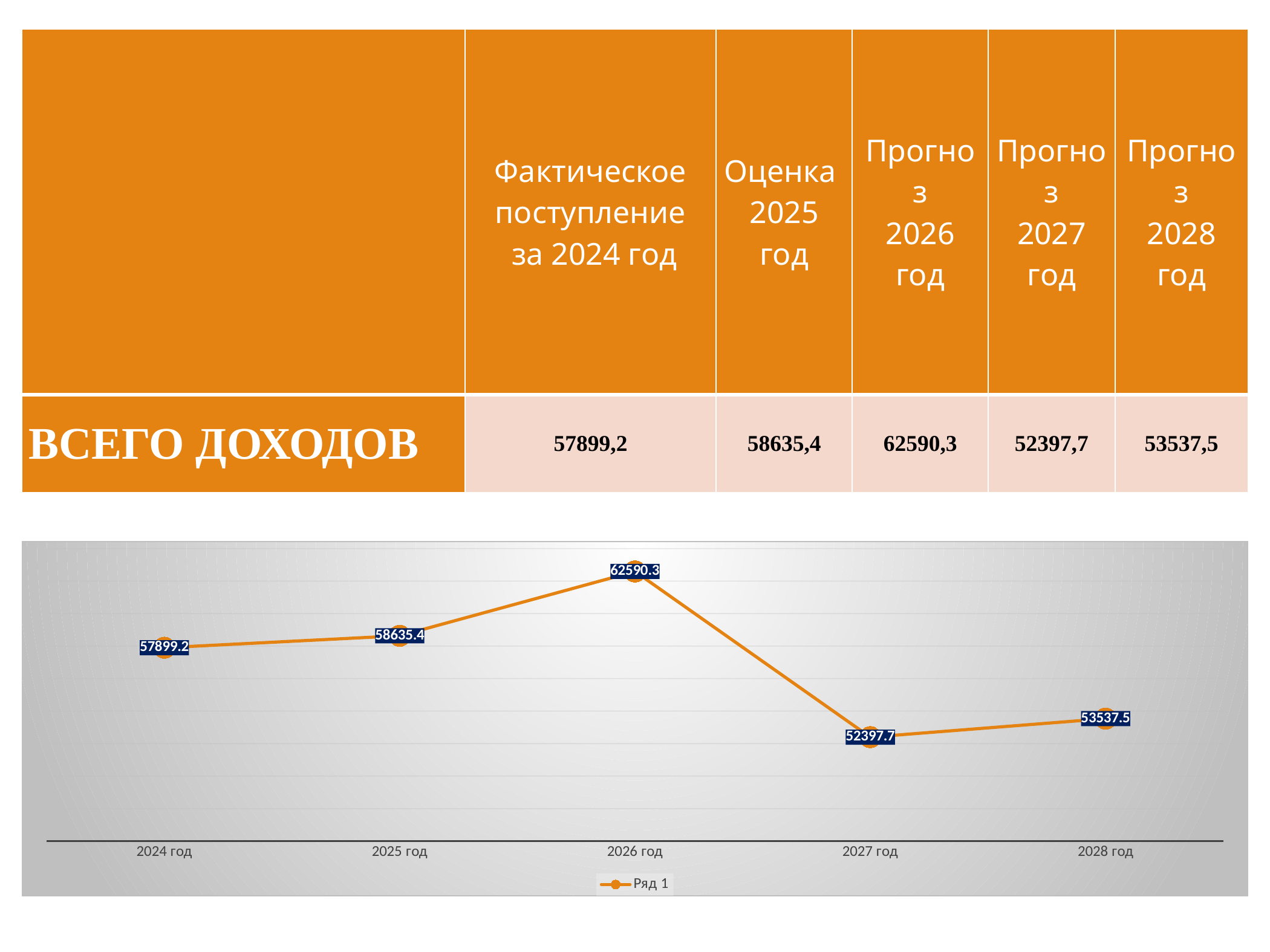
What is the value plotted for 2028 год? 53537.5 How many series does the chart legend list? 1 What kind of chart is shown on the slide? line chart Which year has the lowest value on the chart? 2027 год What is the difference between the values for 2026 год and 2027 год? 10192.6 What is the value plotted for 2024 год? 57899.2 What is the name of the series shown in the chart legend? Ряд 1 Which year has the highest value on the chart? 2026 год Which is larger, the value for 2025 год or the value for 2028 год? 2025 год How many years are plotted on the x axis of the chart? 5 What is the value plotted for 2026 год? 62590.3 What is the difference between the values for 2025 год and 2024 год? 736.2